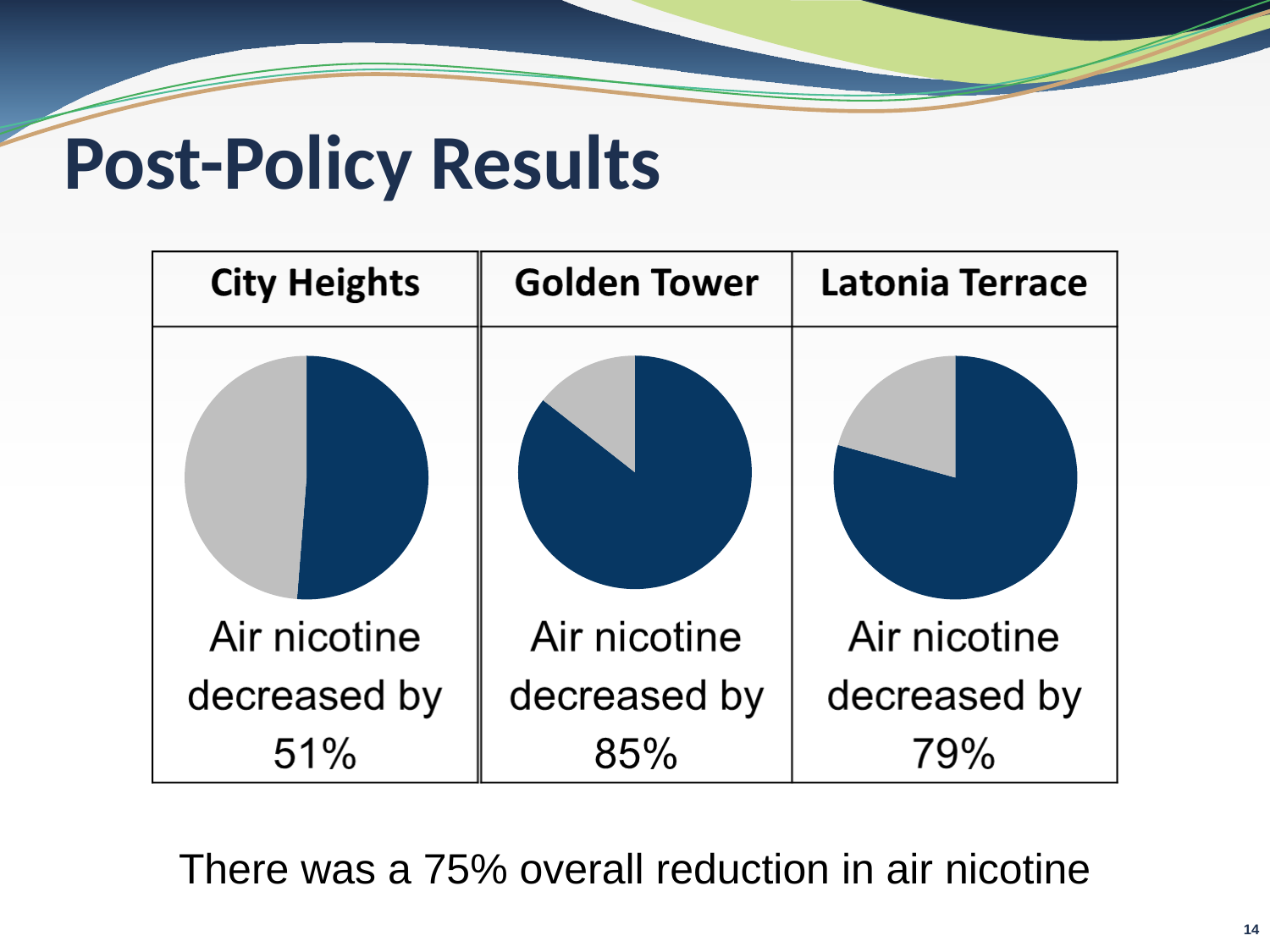
How many pie charts are shown on the slide? 3 Which of the three sites shows the largest decrease in air nicotine? Golden Tower What kind of chart is used for each site on the slide? Pie chart For the City Heights chart, by what percentage did air nicotine decrease? 51% For the Latonia Terrace chart, by what percentage did air nicotine decrease? 79% What is the difference between the air nicotine decrease at Golden Tower and at City Heights? 34 percentage points Which of the three sites shows the smallest decrease in air nicotine? City Heights What is the difference between the air nicotine decrease at Golden Tower and at Latonia Terrace? 6 percentage points Which site had a larger decrease in air nicotine, Latonia Terrace or City Heights? Latonia Terrace According to the text below the charts, what was the overall reduction in air nicotine? 75% In the Golden Tower pie chart, what share of the pie does the dark blue slice represent? 85% For the Golden Tower chart, by what percentage did air nicotine decrease? 85%